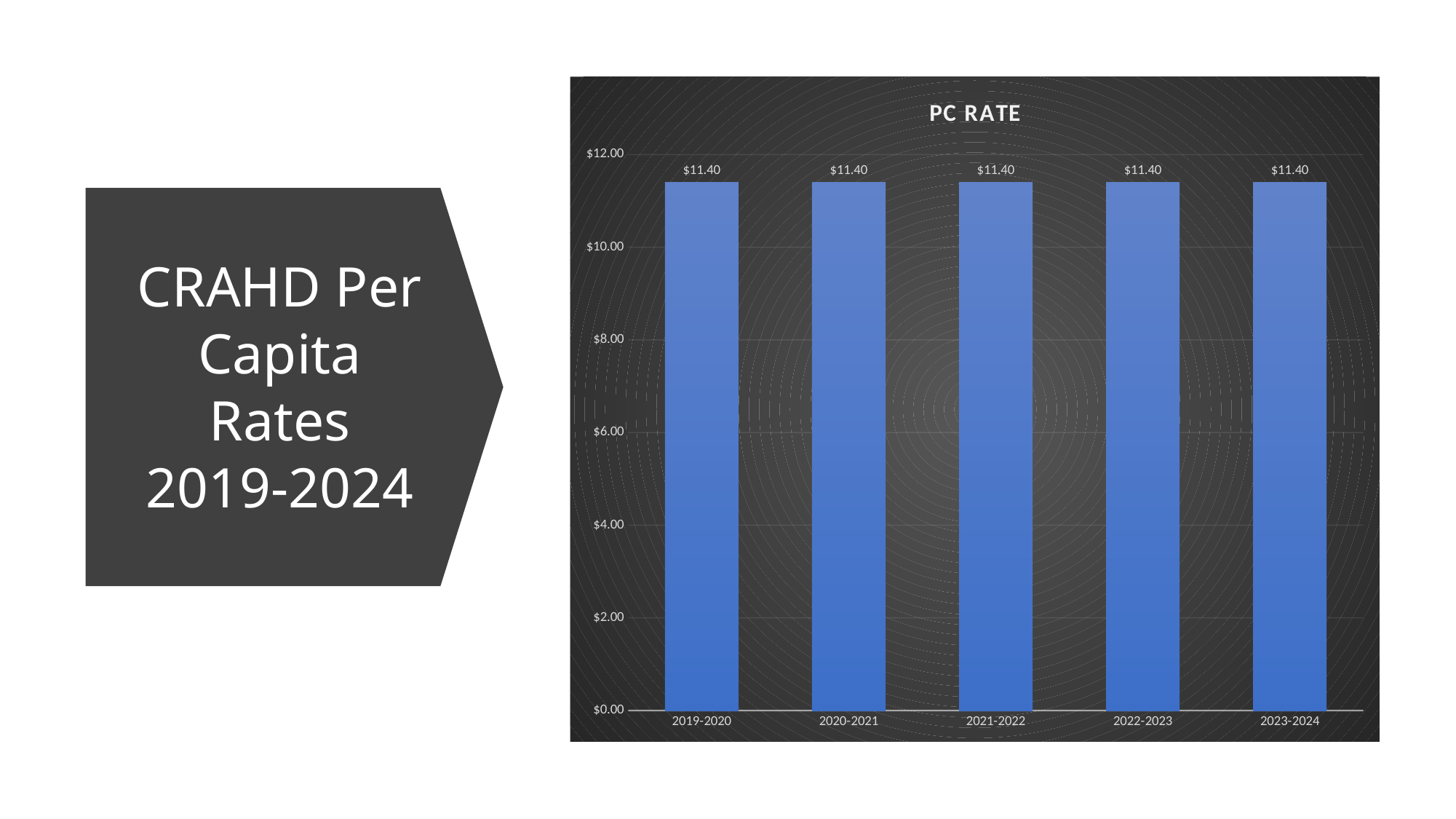
What is the difference between the PC Rate for 2019-2020 and 2023-2024? $0.00 What is the first fiscal year shown on the x axis? 2019-2020 What is the PC Rate for 2021-2022? $11.40 What is the PC Rate for 2023-2024? $11.40 Do the PC Rate values rise, fall, or stay the same from 2019-2020 to 2023-2024? stay the same What is the PC Rate for 2022-2023? $11.40 What is the PC Rate for 2019-2020? $11.40 What is the title of the chart? PC RATE What kind of chart is shown on the slide? bar chart Is the PC Rate for 2022-2023 greater or less than $12.00? less Is the PC Rate for 2020-2021 greater or less than $10.00? greater How many fiscal years are shown on the chart? 5